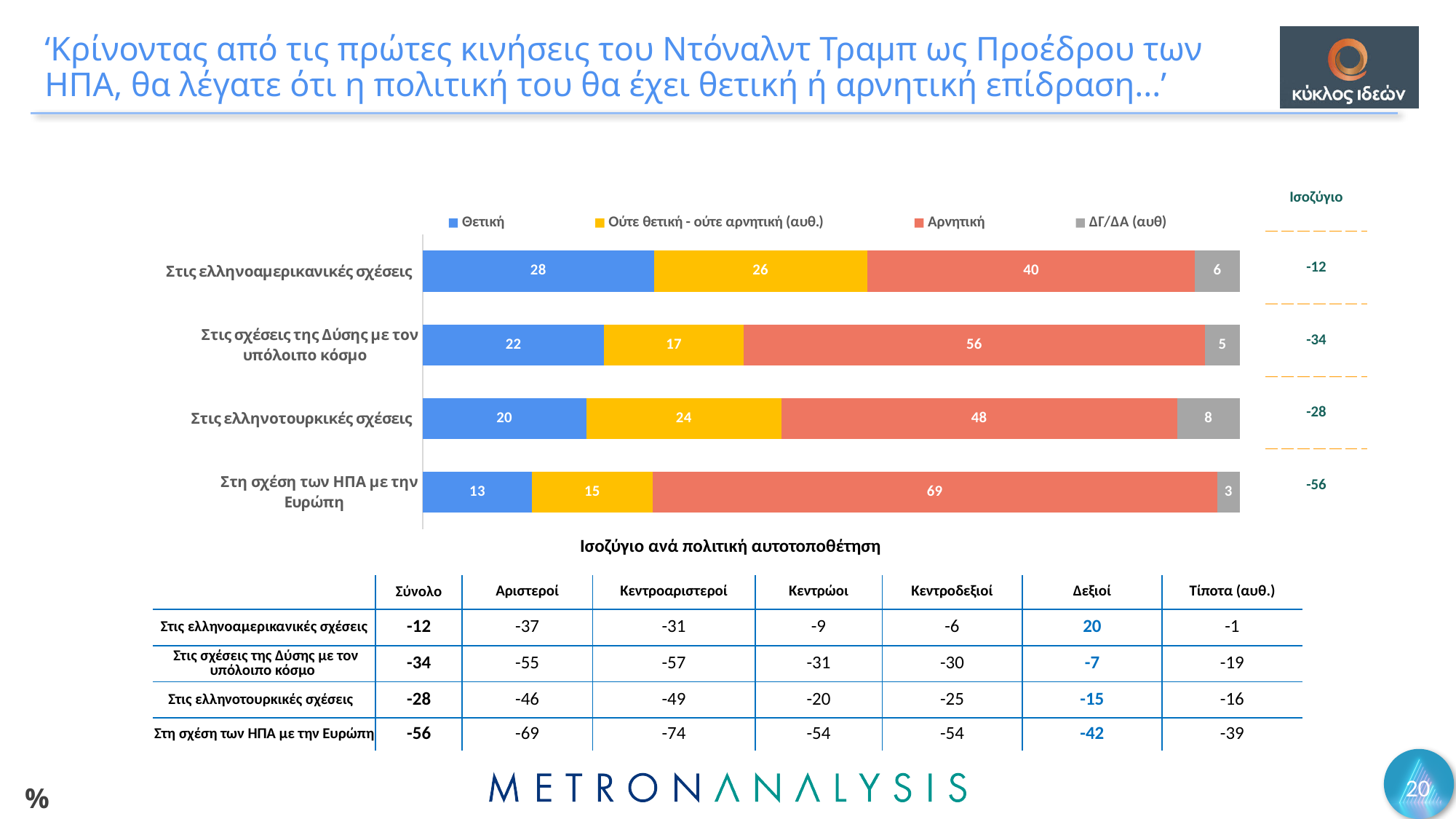
Which category has the lowest Θετική value? Στη σχέση των ΗΠΑ με την Ευρώπη What is the difference between the Αρνητική values for Στις σχέσεις της Δύσης με τον υπόλοιπο κόσμο and Στις ελληνοαμερικανικές σχέσεις? 16 What is the value of Αρνητική for Στη σχέση των ΗΠΑ με την Ευρώπη? 69 What type of chart is shown on the slide? Stacked bar chart Which is larger: the Θετική value for Στις ελληνοαμερικανικές σχέσεις or for Στις ελληνοτουρκικές σχέσεις? Στις ελληνοαμερικανικές σχέσεις How many categories are plotted in the chart? 4 Which category has the highest Αρνητική value? Στη σχέση των ΗΠΑ με την Ευρώπη What is the value of Θετική for Στις ελληνοαμερικανικές σχέσεις? 28 How many series does the chart legend list? 4 What is the value of Ούτε θετική - ούτε αρνητική (αυθ.) for Στις ελληνοτουρκικές σχέσεις? 24 What is the total of the stacked bar for Στις ελληνοτουρκικές σχέσεις? 100 What is the value of ΔΓ/ΔΑ (αυθ) for Στις σχέσεις της Δύσης με τον υπόλοιπο κόσμο? 5